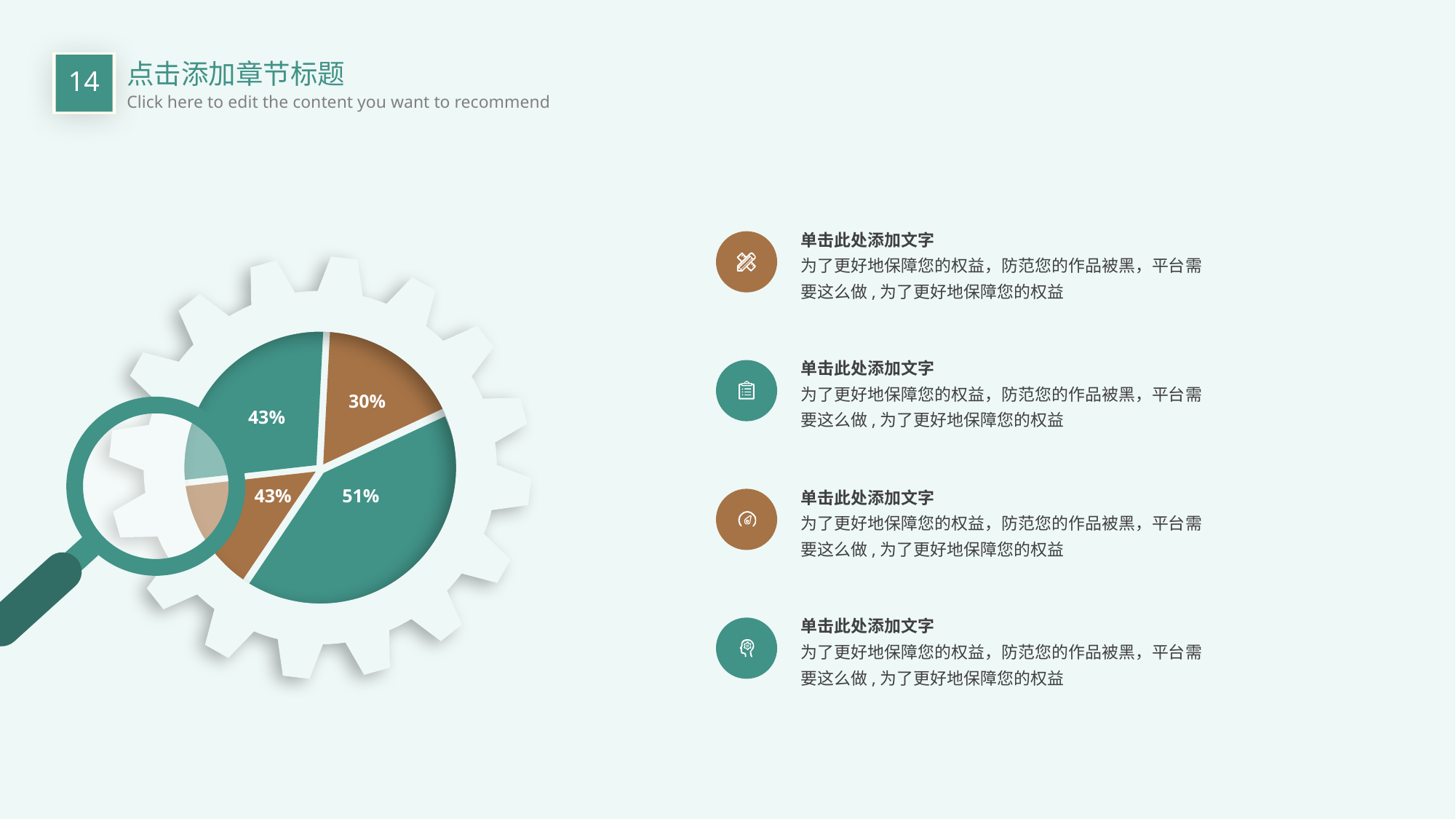
What value is printed on the brown slice at the top right of the pie chart? 30% Which is larger in the pie chart: the slice labelled 51% or the slice labelled 30%? The slice labelled 51% What value is printed on the large teal slice at the bottom right of the pie chart? 51% What is the difference between the largest labelled slice (51%) and the smallest labelled slice (30%) in the pie chart? 21 percentage points What colour is the slice labelled 51% in the pie chart? Teal (green) What is the smallest value labelled on the pie chart? 30% What kind of chart is shown inside the gear graphic on the left of the slide? Pie chart What is the largest value labelled on the pie chart? 51% How many slices of the pie chart are labelled 43%? 2 How many slices does the pie chart have? 4 What colour is the slice labelled 30% in the pie chart? Brown